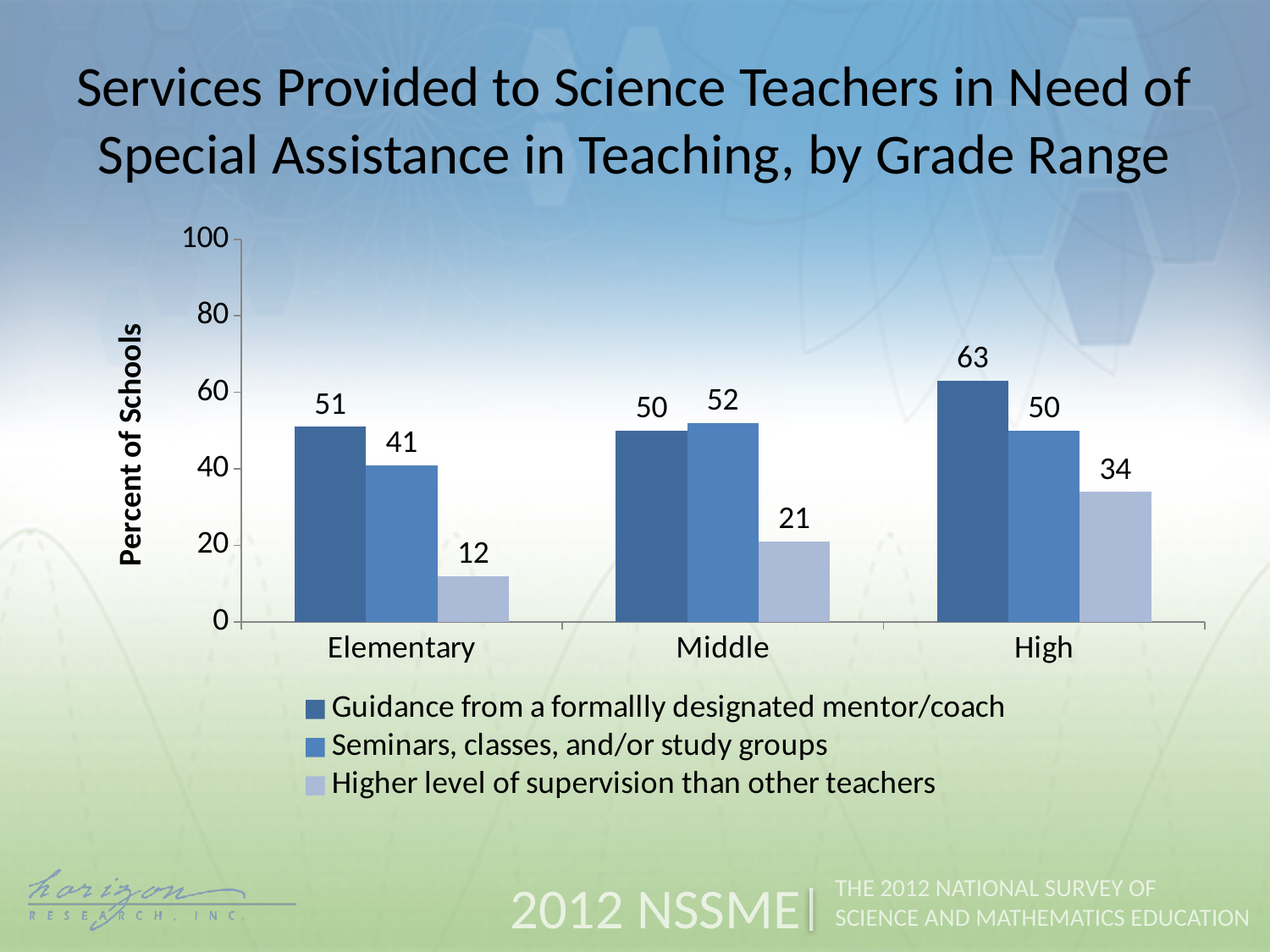
Which is larger: the percent of elementary schools providing guidance from a mentor/coach or the percent providing seminars, classes, and/or study groups? Guidance from a formallly designated mentor/coach Which grade range has the highest percent of schools providing guidance from a formally designated mentor/coach? High What is the difference between the percent of high schools and elementary schools providing a higher level of supervision than other teachers? 22 What is the label of the y axis? Percent of Schools Does the percent of schools providing a higher level of supervision than other teachers rise or fall from Elementary to High? Rise What percent of high schools provide guidance from a formally designated mentor/coach? 63 How many grade ranges are shown on the x axis? 3 What percent of middle schools provide seminars, classes, and/or study groups? 52 Which grade range has the lowest percent of schools providing a higher level of supervision than other teachers? Elementary What kind of chart is shown on the slide? Bar chart What percent of elementary schools provide a higher level of supervision than other teachers? 12 How many series does the legend list? 3